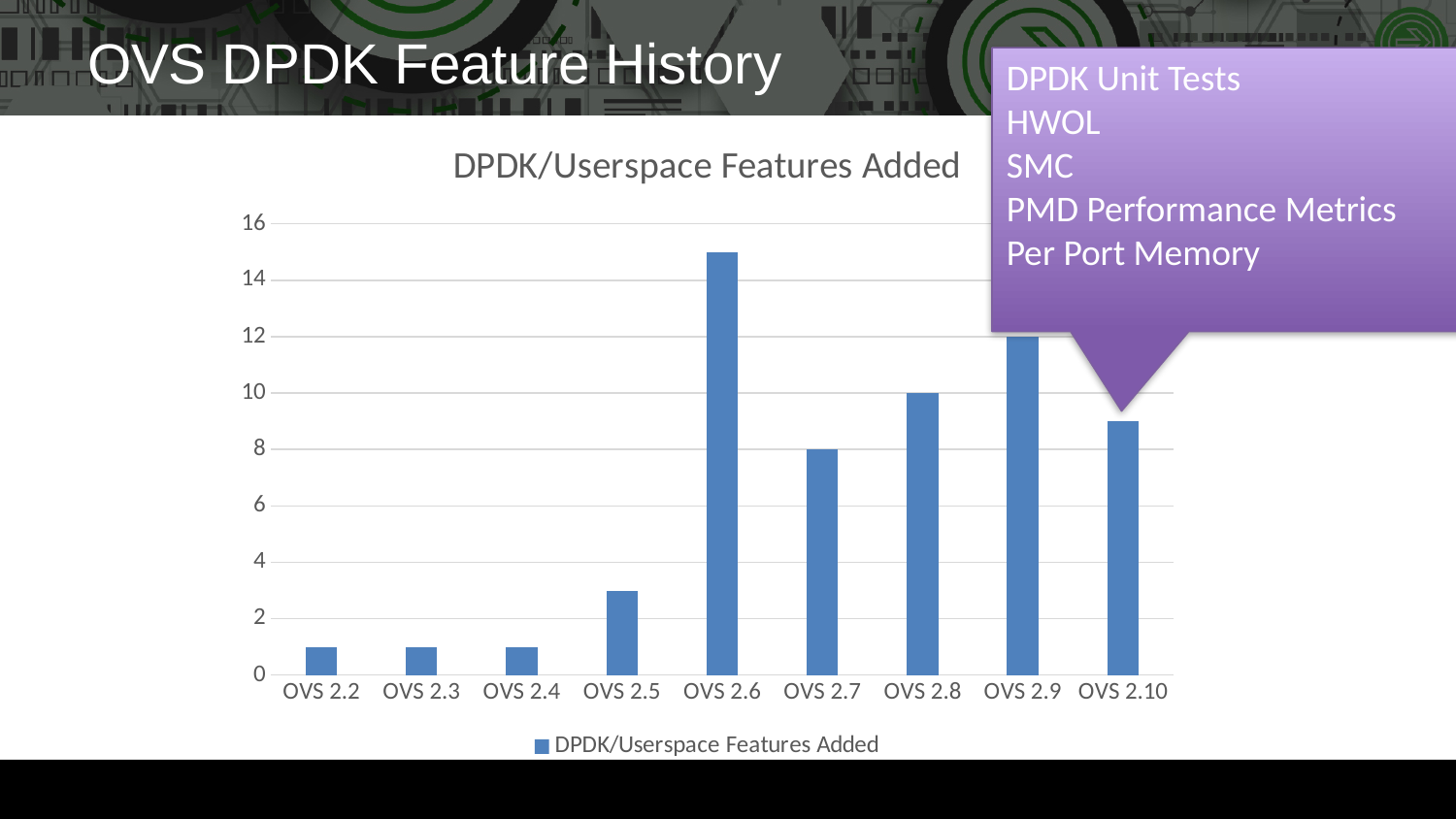
What type of chart is shown on the slide? Bar chart Which has a larger value, OVS 2.8 or OVS 2.7? OVS 2.8 Is the value for OVS 2.10 greater or less than 10? less Do the values rise or fall from OVS 2.2 to OVS 2.6? rise What is the difference between the values for OVS 2.8 and OVS 2.7? 2 Which OVS version has the highest number of DPDK/Userspace features added? OVS 2.6 Is the value for OVS 2.6 greater or less than 14? greater What is the title of the chart? DPDK/Userspace Features Added How many OVS versions (categories) are shown on the x axis? 9 How many series does the legend list? 1 How many DPDK/Userspace features were added in OVS 2.7? 8 How many DPDK/Userspace features were added in OVS 2.8? 10